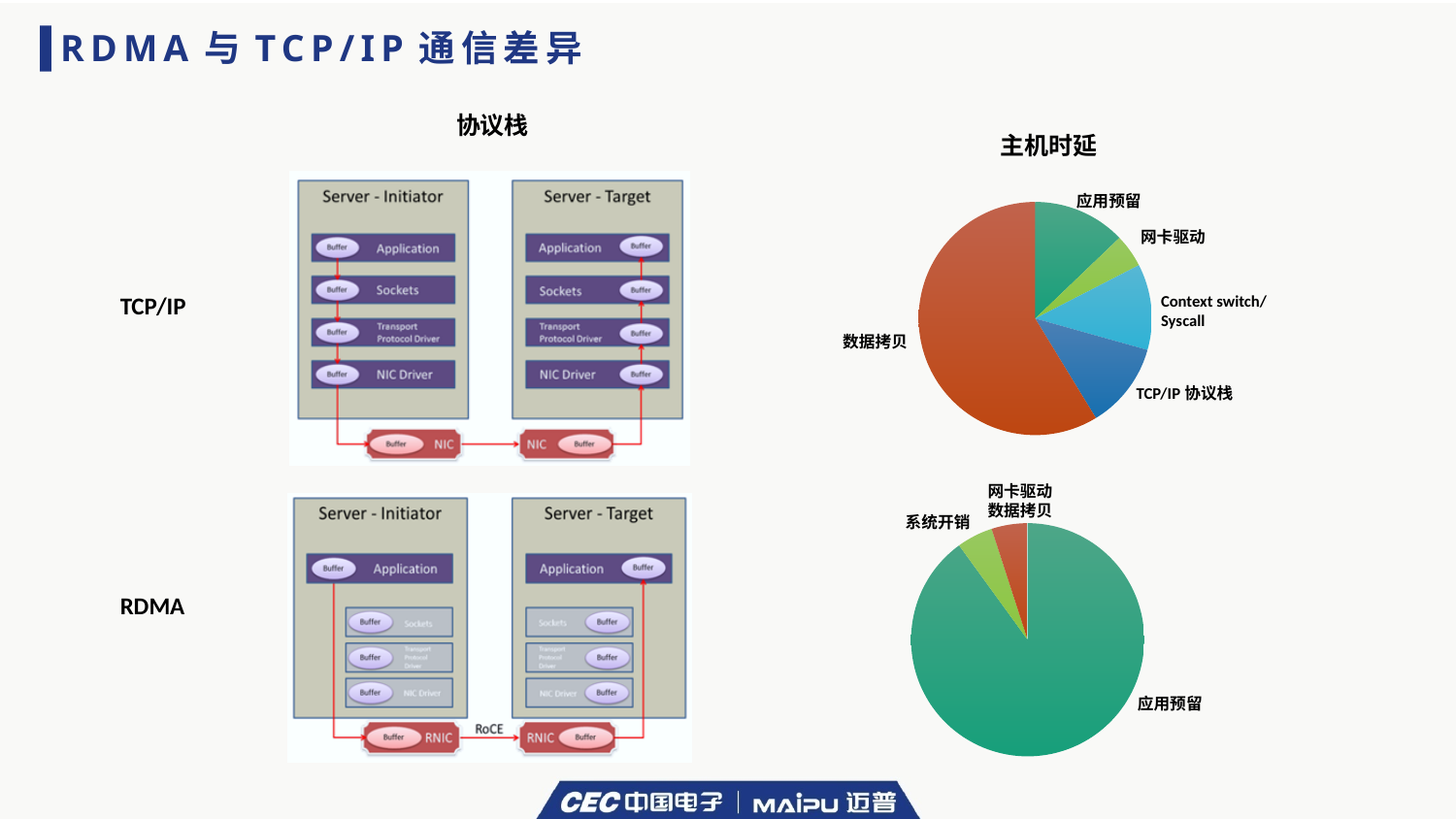
In the top pie chart (TCP/IP), which is larger: 数据拷贝 or 应用预留? 数据拷贝 In the top pie chart (TCP/IP), which is larger: Context switch/Syscall or 网卡驱动? Context switch/Syscall In the bottom pie chart (RDMA), which category has the largest share? 应用预留 What kind of chart is the top chart under 主机时延? pie chart In the top pie chart (TCP/IP), which category has the largest share? 数据拷贝 What is the title shown above the two pie charts? 主机时延 In the bottom pie chart (RDMA), which is larger: 应用预留 or 系统开销? 应用预留 In the top pie chart (TCP/IP), how many slices are there? 5 What kind of chart is the bottom chart under 主机时延? pie chart In the top pie chart (TCP/IP), which category has the smallest share? 网卡驱动 In the top pie chart (TCP/IP), what colour is the 数据拷贝 slice? red In the bottom pie chart (RDMA), how many slices are there? 3